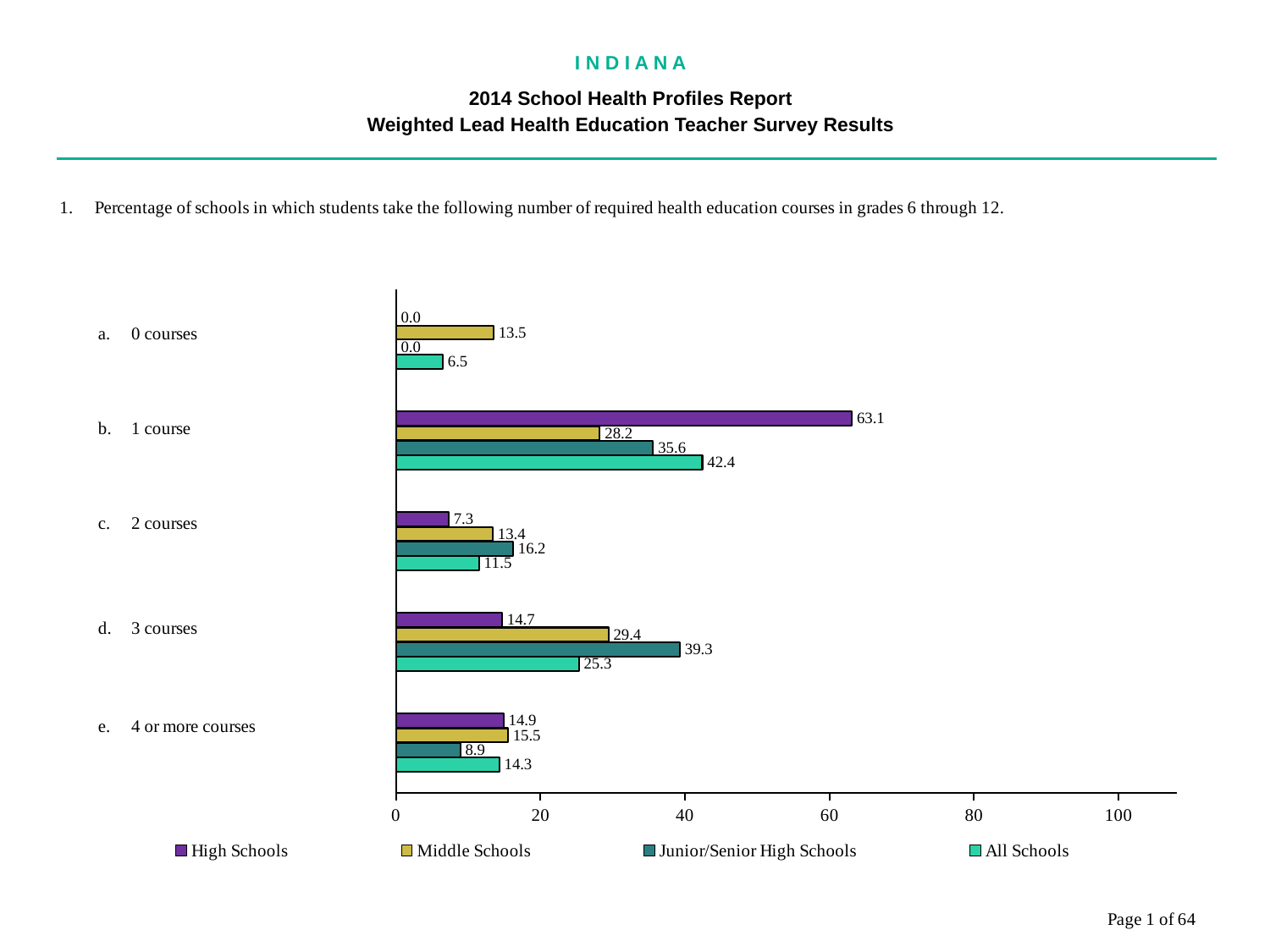
What is the difference between the High Schools and Middle Schools values for '1 course'? 34.9 How many series does the legend list? 4 What is the value for Junior/Senior High Schools in the '3 courses' category? 39.3 What is the value for All Schools in the '4 or more courses' category? 14.3 For '3 courses', which is larger: the Middle Schools value or the High Schools value? Middle Schools Which category has the lowest value for Junior/Senior High Schools? 0 courses What is the value for Middle Schools in the '0 courses' category? 13.5 Is the All Schools value for '1 course' greater or less than 40? greater What percentage of High Schools require 1 course of health education? 63.1 Which category has the highest value for High Schools? 1 course How many course categories are shown on the chart? 5 What type of chart is shown on the slide? bar chart